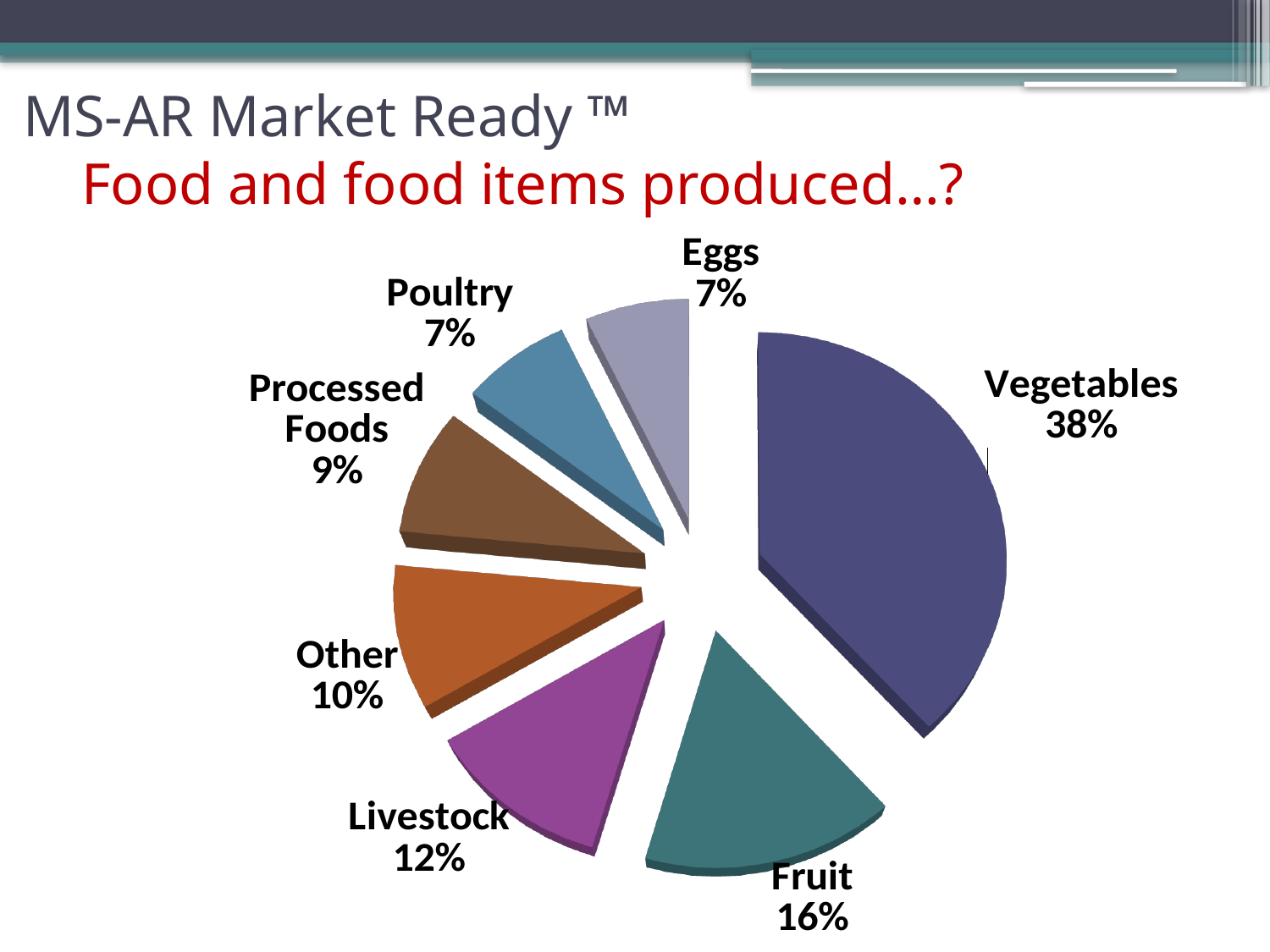
What percentage of the pie is Processed Foods? 9% Which two categories share the smallest percentage, 7%? Poultry and Eggs What percentage of the pie is Livestock? 12% What kind of chart is shown on the slide? pie chart How many slices does the pie chart have? 7 Which is larger, the share for Other or the share for Processed Foods? Other What is the combined share of Poultry and Eggs? 14% What is the difference in percentage points between Vegetables and Fruit? 22 What percentage of the pie is Vegetables? 38% What is the red subtitle above the chart? Food and food items produced...? Which category has the largest share of the pie? Vegetables What percentage of the pie is Fruit? 16%